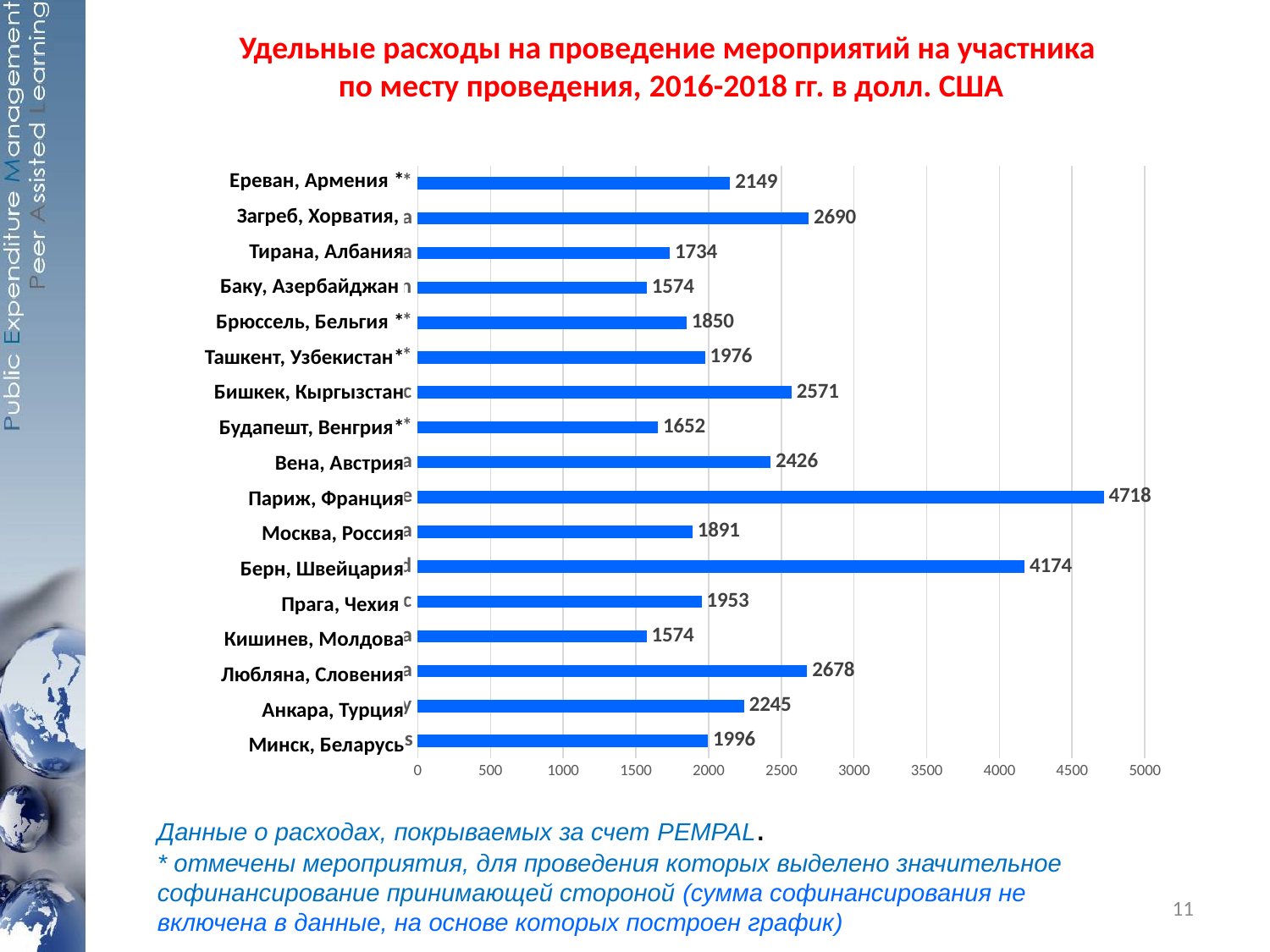
What is the value for Минск, Беларусь? 1996 What is the maximum value shown on the horizontal axis? 5000 What is the difference between the values for Вена, Австрия and Ереван, Армения? 277 What kind of chart is shown on the slide? bar chart How many cities are shown on the chart? 17 What is the difference between the values for Париж, Франция and Берн, Швейцария? 544 What is the value for Париж, Франция? 4718 Which is larger, the value for Бишкек, Кыргызстан or the value for Вена, Австрия? Бишкек, Кыргызстан Is the value for Москва, Россия greater or less than 2000? less What is the value for Бишкек, Кыргызстан? 2571 Which city has the highest value? Париж, Франция What is the lowest value shown on the chart? 1574